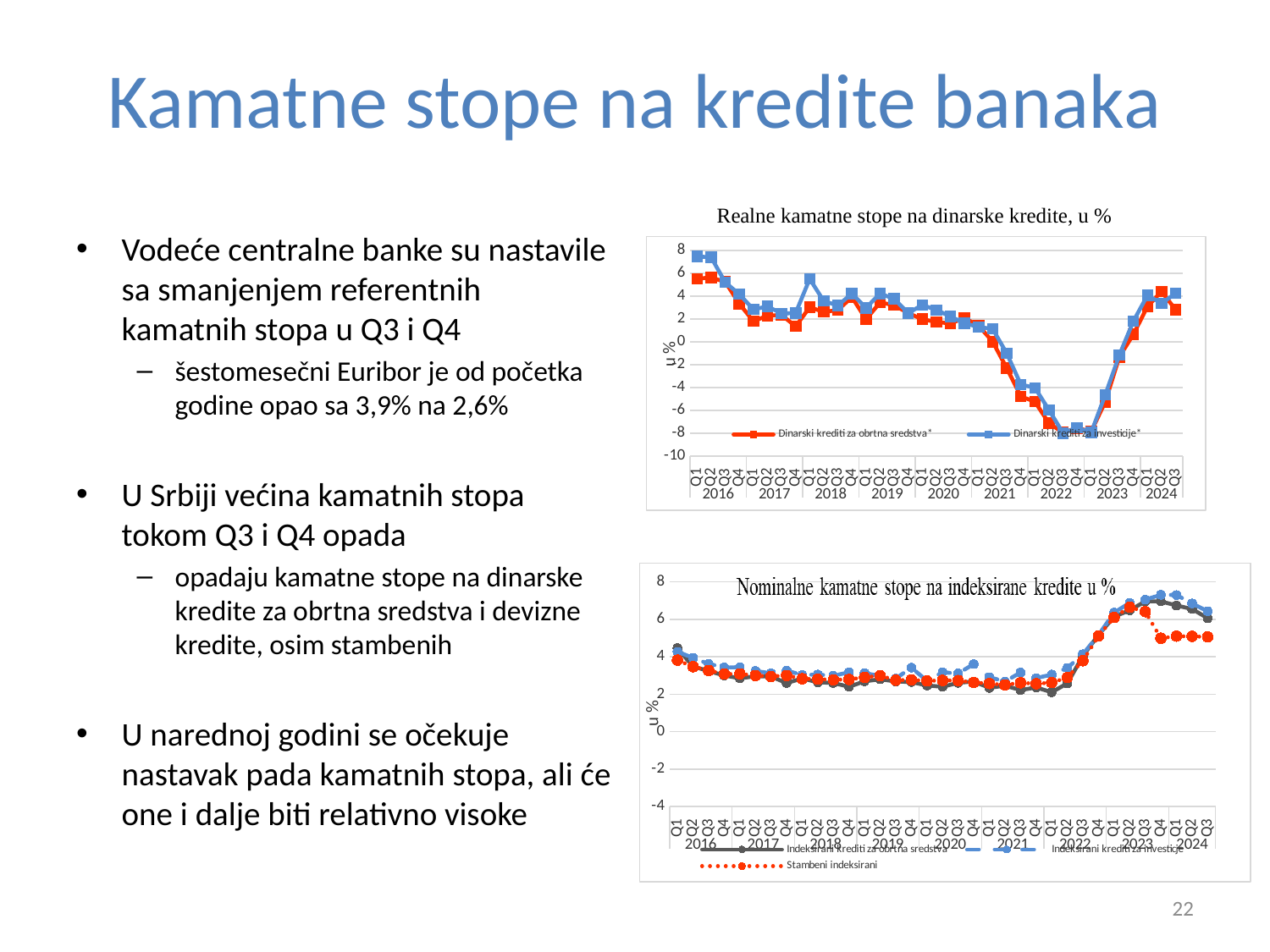
In the top chart 'Realne kamatne stope na dinarske kredite, u %', do the values for 'Dinarski krediti za obrtna sredstva*' rise or fall from Q1 2016 to Q4 2022? fall What is the title of the top chart on the slide? Realne kamatne stope na dinarske kredite, u % In the bottom chart 'Nominalne kamatne stope na indeksirane kredite u %', is the value for 'Stambeni indeksirani' in Q3 2024 greater or less than 6? less How many series does the legend of the top chart 'Realne kamatne stope na dinarske kredite, u %' list? 2 How many series does the legend of the bottom chart 'Nominalne kamatne stope na indeksirane kredite u %' list? 3 What kind of chart is the bottom chart titled 'Nominalne kamatne stope na indeksirane kredite u %'? line chart In the top chart 'Realne kamatne stope na dinarske kredite, u %', is the value for 'Dinarski krediti za obrtna sredstva*' in Q4 2022 greater or less than -6? less In the top chart 'Realne kamatne stope na dinarske kredite, u %', is the value for 'Dinarski krediti za investicije*' in Q1 2016 greater or less than 6? greater What kind of chart is the top chart titled 'Realne kamatne stope na dinarske kredite, u %'? line chart In the bottom chart 'Nominalne kamatne stope na indeksirane kredite u %', do the values for 'Indeksirani krediti za obrtna sredstva' rise or fall from Q1 2022 to Q4 2023? rise In the top chart 'Realne kamatne stope na dinarske kredite, u %', do the values for 'Dinarski krediti za investicije*' rise or fall from Q4 2022 to Q1 2024? rise